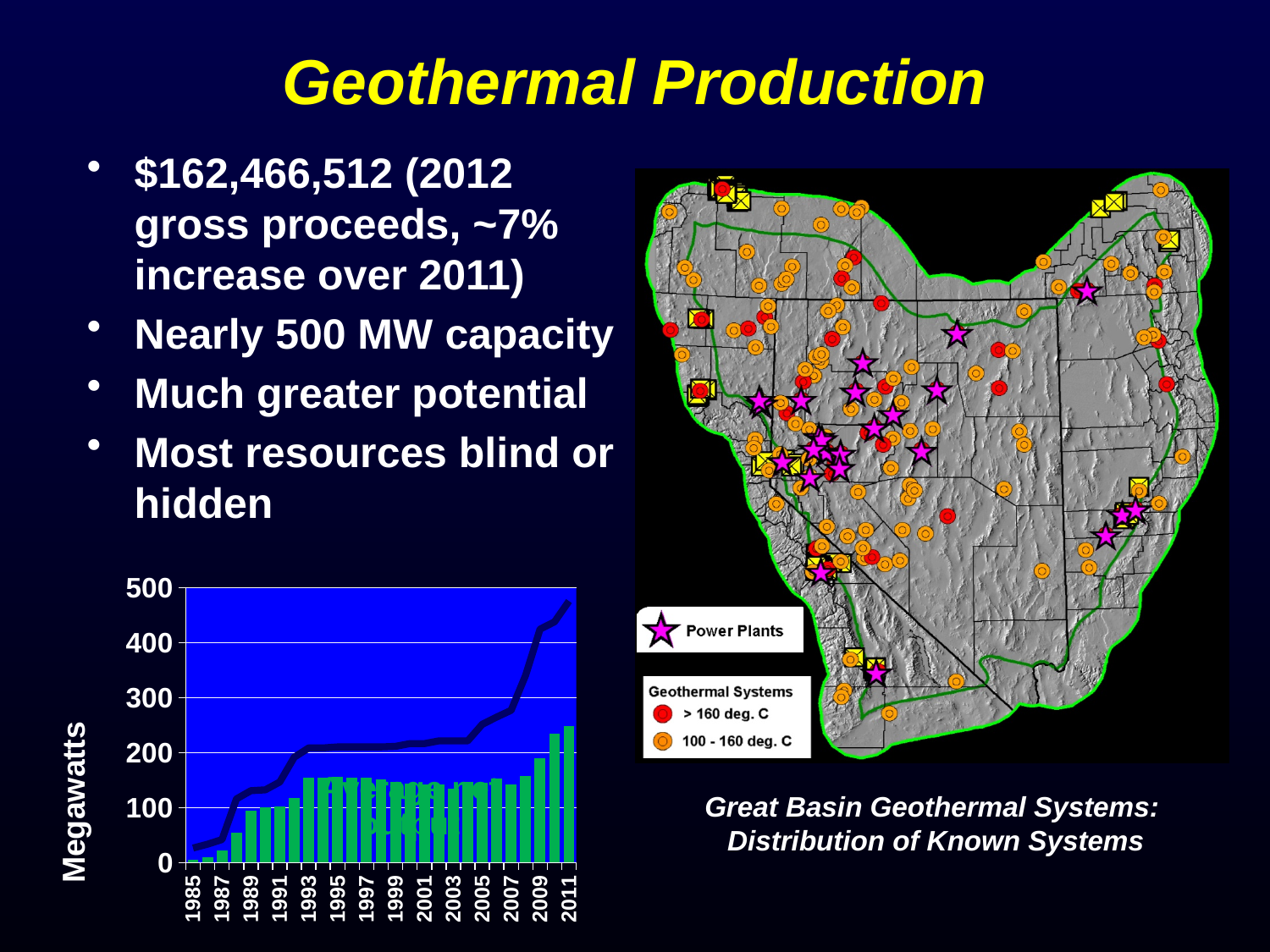
Is the bar for 1993 greater or less than 100 megawatts? greater What kind of chart is shown at the bottom left of the slide? bar chart with a line Which year has the shortest bar in the chart? 1985 What is the label on the y-axis of the chart? Megawatts Is the line value for 2011 greater or less than 400 megawatts? greater Is the bar for 1985 greater or less than 100 megawatts? less What is the highest value shown on the y-axis of the chart? 500 Which bar is taller, 2011 or 1987? 2011 Does the line in the chart generally rise or fall from 1985 to 2011? rise How many year labels are shown along the x-axis of the chart? 14 Which year has the tallest bar in the chart? 2011